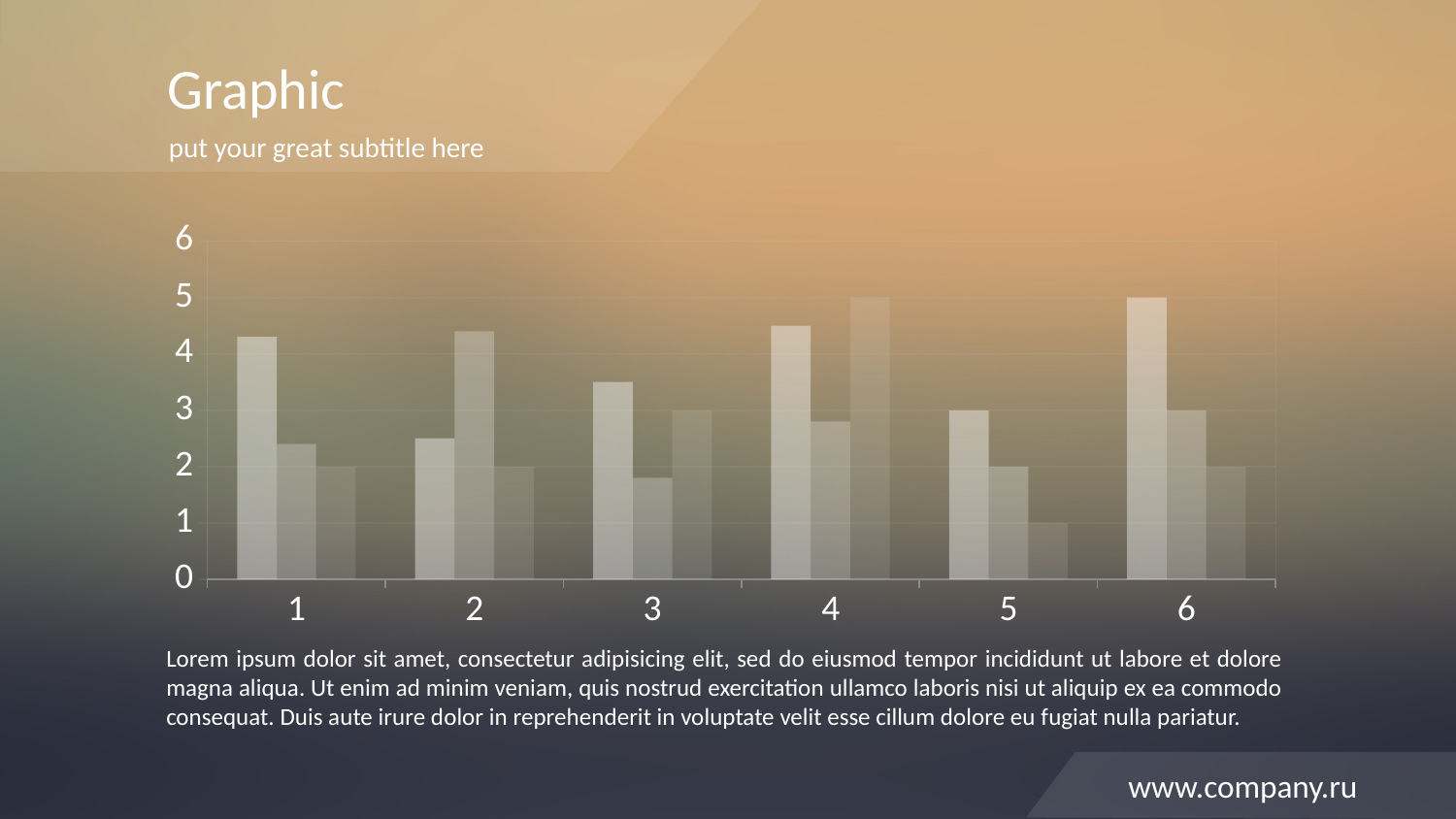
How many bars are plotted for each category on the chart? 3 Which bar in category 5 is the shortest: the first, second or third? third Is the value of the second bar in category 3 greater or less than 3? less What kind of chart is shown on the slide? bar chart Which is larger: the first bar in category 6 or the first bar in category 5? the first bar in category 6 What is the difference between the first bar and the third bar in category 5? 2 What is the value of the third bar in category 5? 1 What is the value of the first bar in category 6? 5 How many categories are shown on the x axis of the chart? 6 Is the value of the first bar in category 1 greater or less than 4? greater What is the value of the third bar in category 4? 5 What is the value of the third bar in category 3? 3